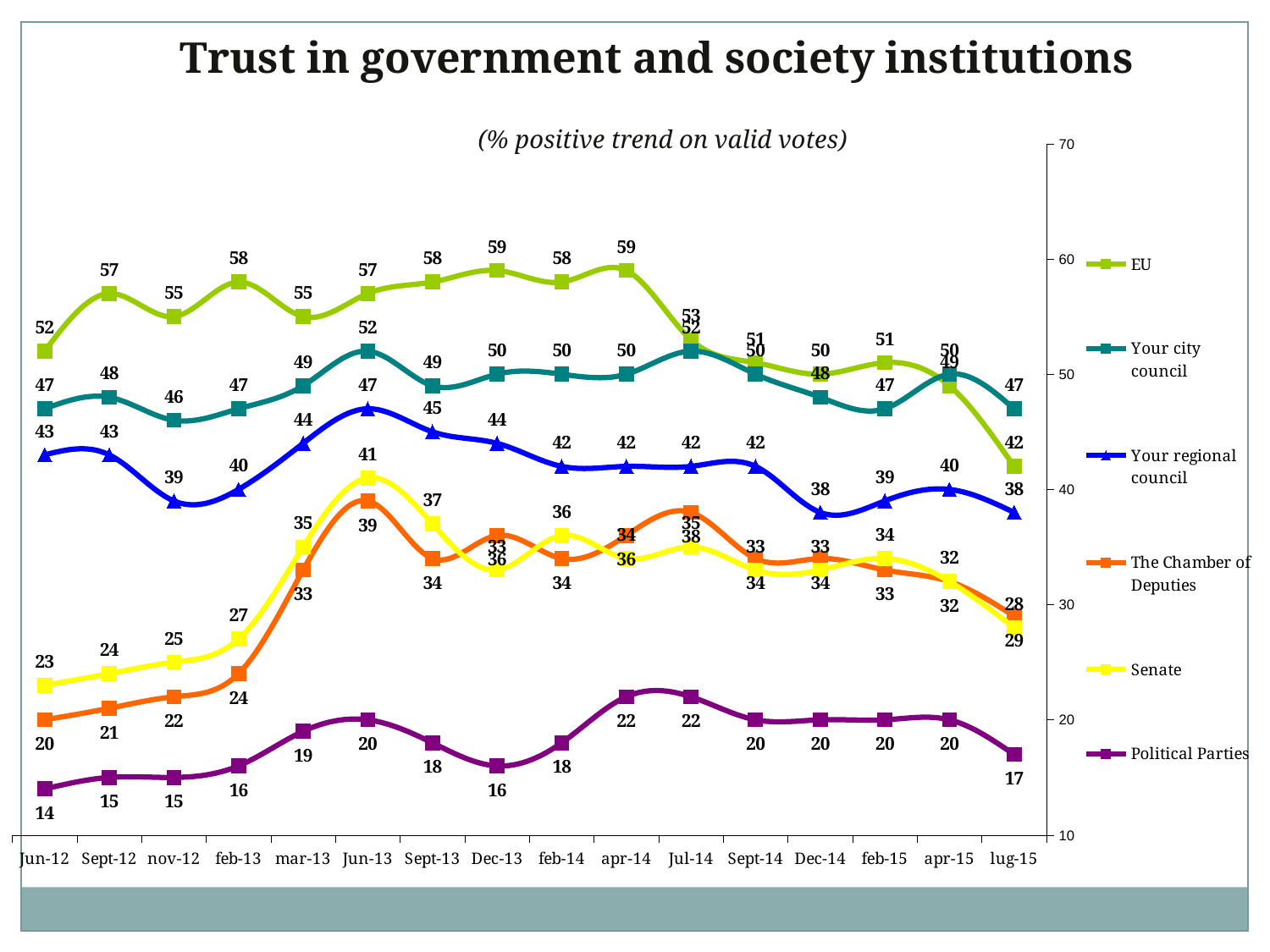
Does the EU series rise or fall from apr-14 to lug-15? Fall At which date is the Political Parties series at its lowest? Jun-12 How many series does the legend list? 6 What is the value for Your regional council at lug-15? 38 At Jun-13, which is higher: Senate or The Chamber of Deputies? Senate What kind of chart is shown on the slide? Line chart What is the value for Your city council at Jun-13? 52 What is the value for EU at Jun-12? 52 How many dates are shown on the x axis? 16 What is the value for Political Parties at Jun-12? 14 What is the highest value reached by the EU series? 59 What is the difference between the EU value and the Political Parties value at lug-15? 25